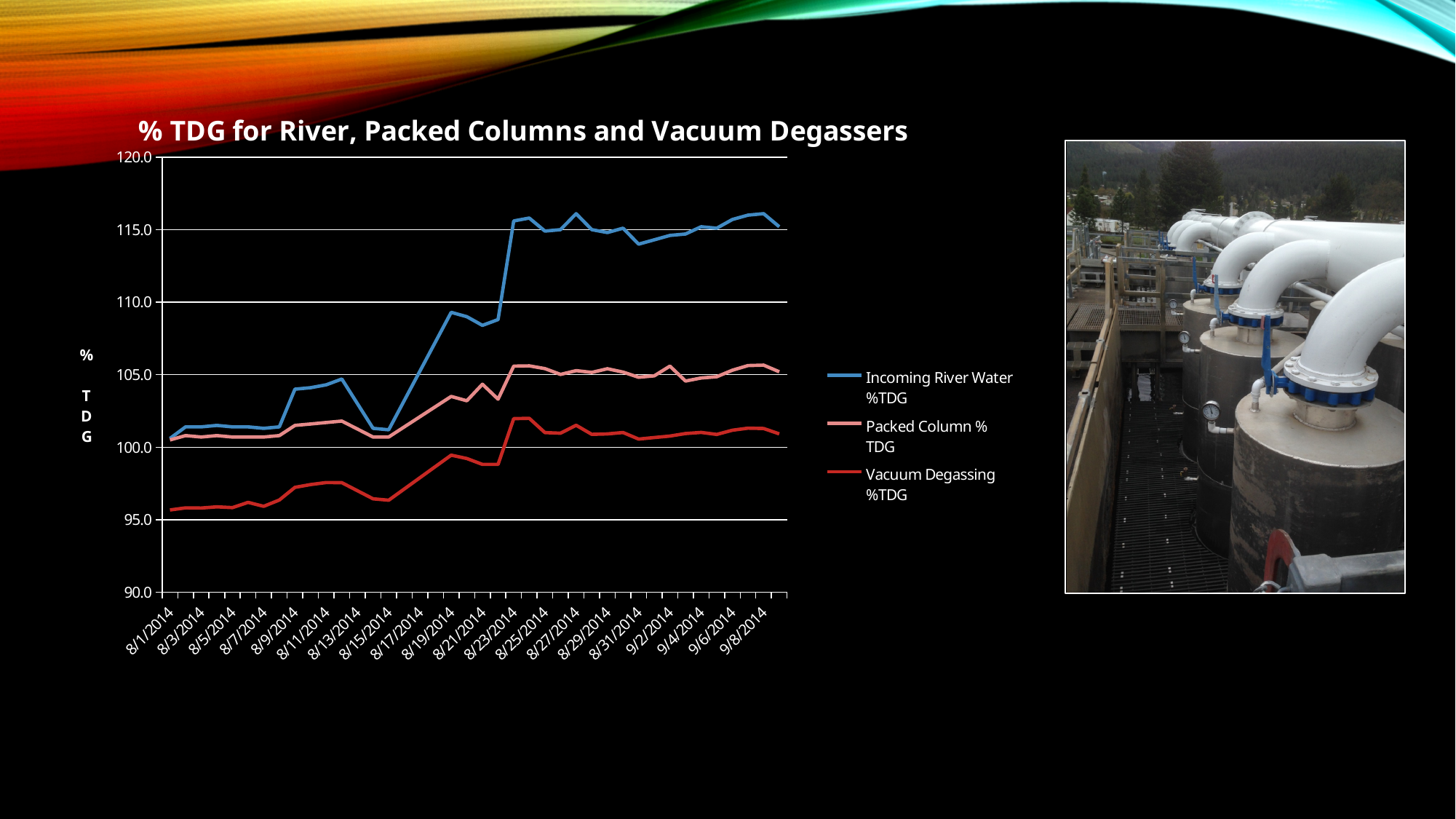
Is the value for Incoming River Water %TDG on 8/19/2014 greater or less than 105? greater Does the Incoming River Water %TDG series rise or fall overall from 8/1/2014 to 9/8/2014? rise Which series has the lowest values across the chart? Vacuum Degassing %TDG Is the value for Vacuum Degassing %TDG on 8/13/2014 greater or less than 100? less Which series is drawn in blue in the chart? Incoming River Water %TDG Is the value for Vacuum Degassing %TDG on 8/1/2014 greater or less than 100? less How many series does the chart's legend list? 3 What kind of chart is shown on the slide? line chart On 8/1/2014, which is higher: Incoming River Water %TDG or Vacuum Degassing %TDG? Incoming River Water %TDG What is the title of the chart? % TDG for River, Packed Columns and Vacuum Degassers